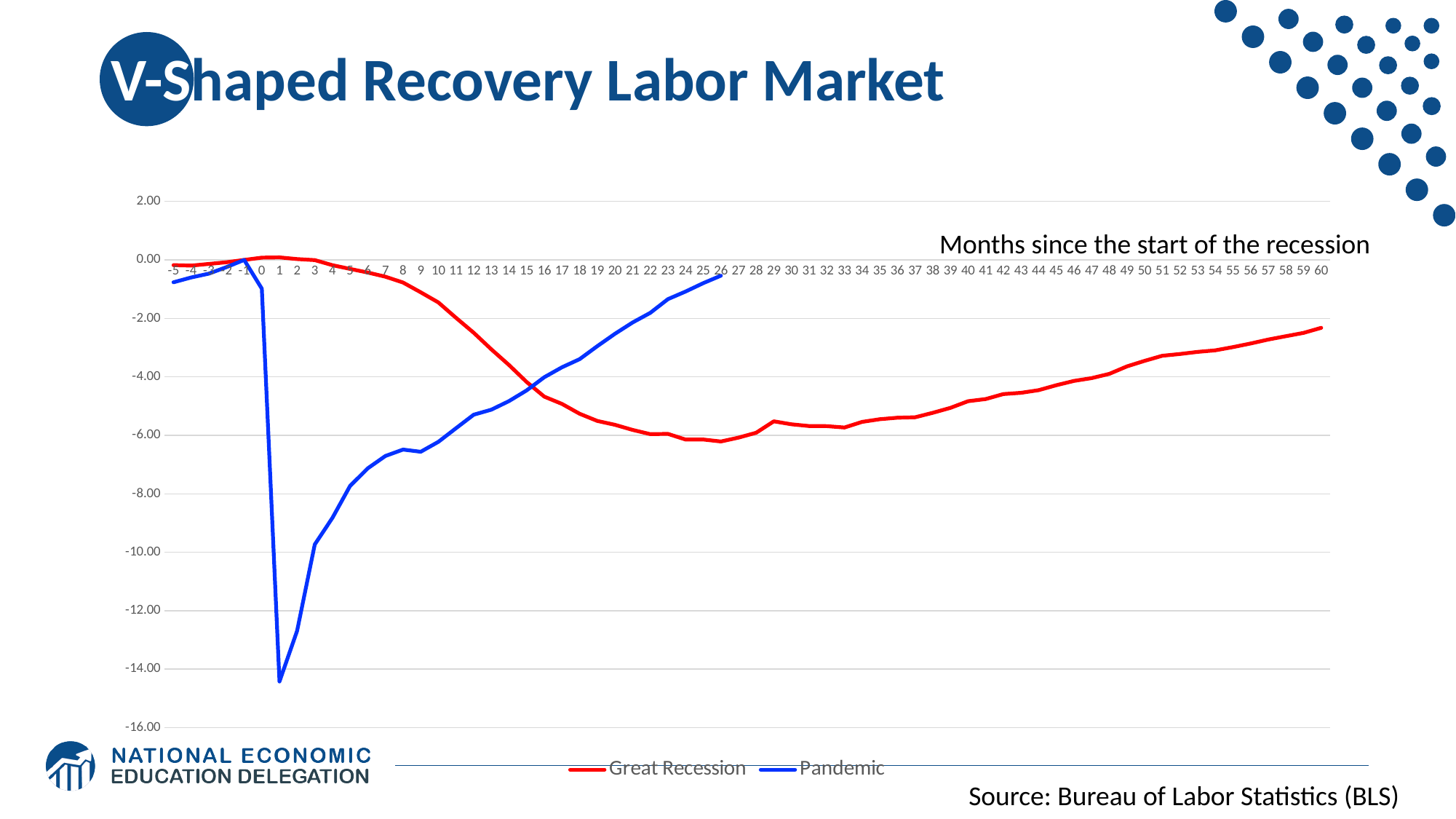
Is the lowest value of the Pandemic series greater or less than -12.00? less What is the label given for the x axis? Months since the start of the recession At month 10, which series has the lower value, Great Recession or Pandemic? Pandemic Is the value of the Pandemic series at month 3 greater or less than -8.00? less What are the two series named in the legend? Great Recession and Pandemic Which series reaches the lowest value on the chart? Pandemic Does the Great Recession series rise or fall between month 30 and month 60? rise What kind of chart is shown on the slide? line chart How many series does the legend list? 2 Is the lowest value of the Great Recession series greater or less than -8.00? greater At month 20, which series has the higher value, Great Recession or Pandemic? Pandemic